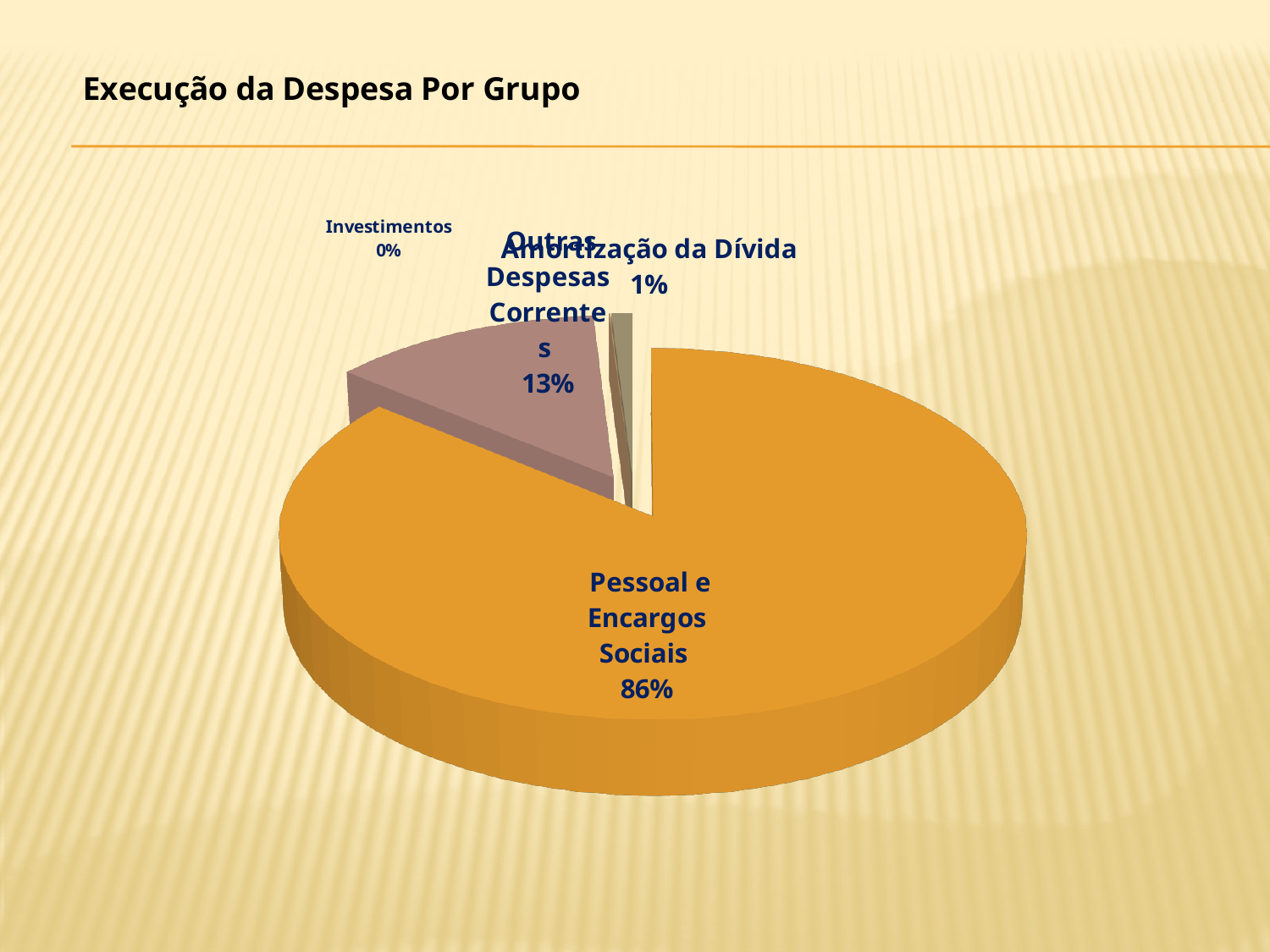
Which category has the largest slice of the pie? Pessoal e Encargos Sociais What kind of chart is shown on the slide? pie chart What is the title of the chart? Execução da Despesa Por Grupo What share of the pie does Outras Despesas Correntes represent? 13% What share of the pie does Amortização da Dívida represent? 1% What share of the pie does Pessoal e Encargos Sociais represent? 86% What colour is the Pessoal e Encargos Sociais slice? orange How many categories are shown in the pie chart? 4 Which category has the smallest slice of the pie? Investimentos What is the difference in percentage points between Pessoal e Encargos Sociais and Outras Despesas Correntes? 73 Which is larger, Outras Despesas Correntes or Amortização da Dívida? Outras Despesas Correntes